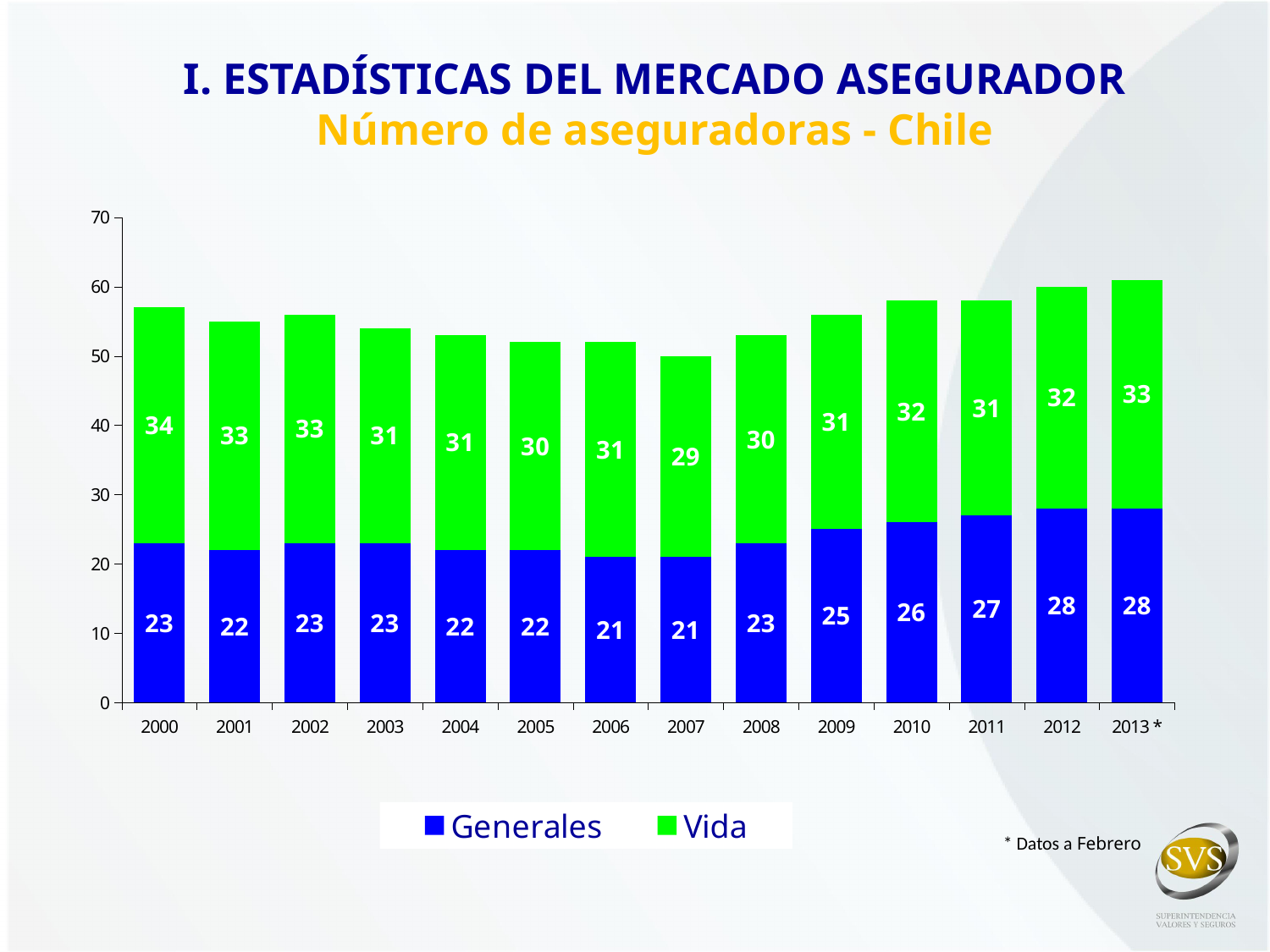
Which year has the lowest value for Vida? 2007 How many series does the legend list? 2 What is the value for Vida in 2007? 29 How many years are shown on the x axis? 14 What is the total of the stacked bar for 2007? 50 What is the value for Vida in 2000? 34 What is the total of the stacked bar for 2013*? 61 What is the difference between the Generales values for 2013* and 2007? 7 Which year has the highest value for Vida? 2000 What kind of chart is shown on the slide? Stacked bar chart What is the value for Generales in 2011? 27 Which is larger, the Vida value in 2010 or the Vida value in 2011? 2010